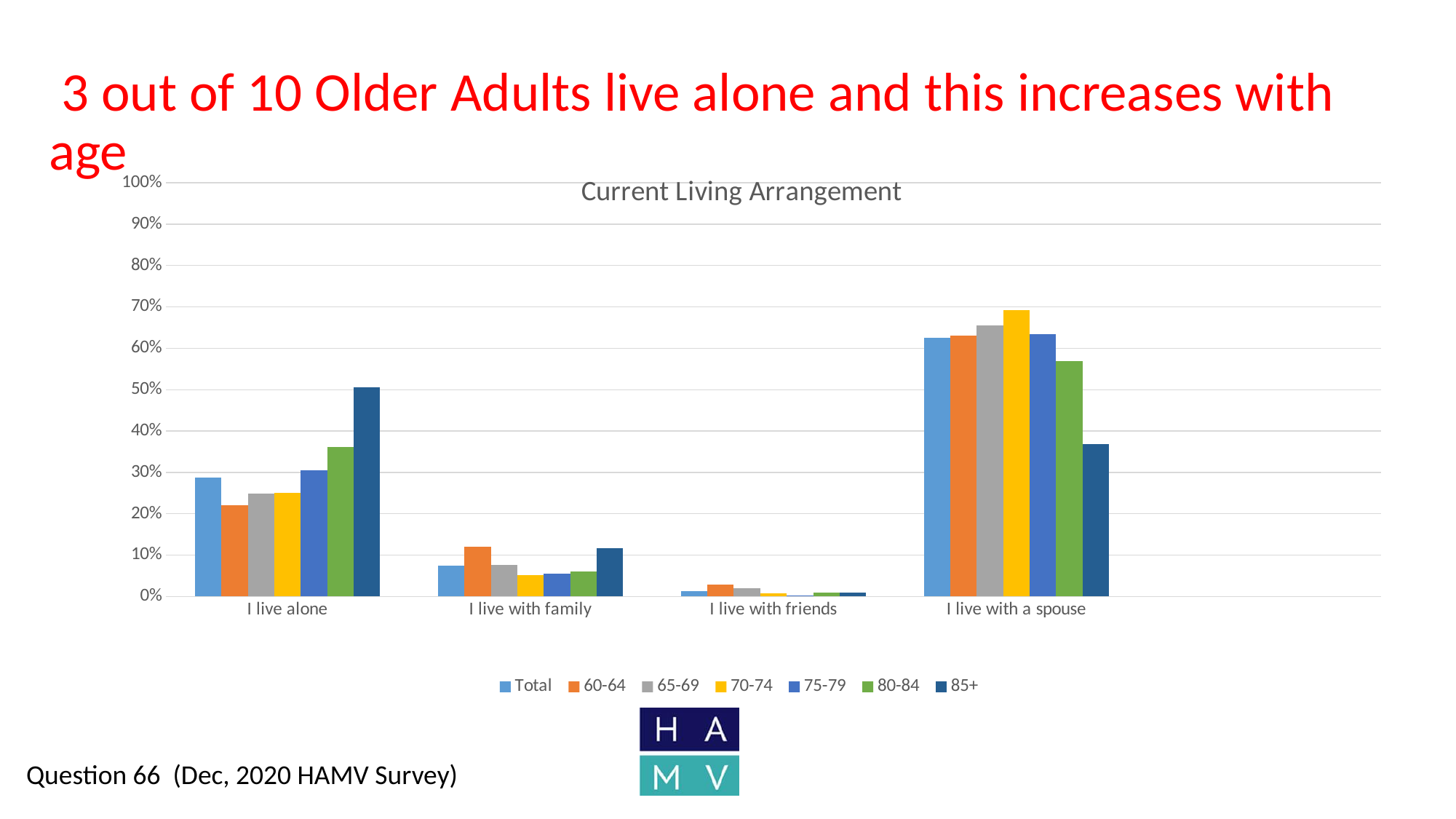
How many series does the legend list? 7 How many living arrangement categories are shown on the x axis? 4 For "I live alone", do the values generally rise or fall as the age groups go from 60-64 to 85+? rise Is the value for the 85+ group in "I live alone" greater or less than 40%? greater Which age group has the lowest value for "I live with a spouse"? 85+ Which living arrangement category has the highest value for the 70-74 group? I live with a spouse What kind of chart is shown on the slide? bar chart For "I live with family", which is larger: the 60-64 group or the 70-74 group? 60-64 What is the title of the chart? Current Living Arrangement Is the value for the 85+ group in "I live with a spouse" greater or less than 50%? less Which living arrangement category has the lowest value for the Total series? I live with friends Which age group has the highest value for "I live alone"? 85+